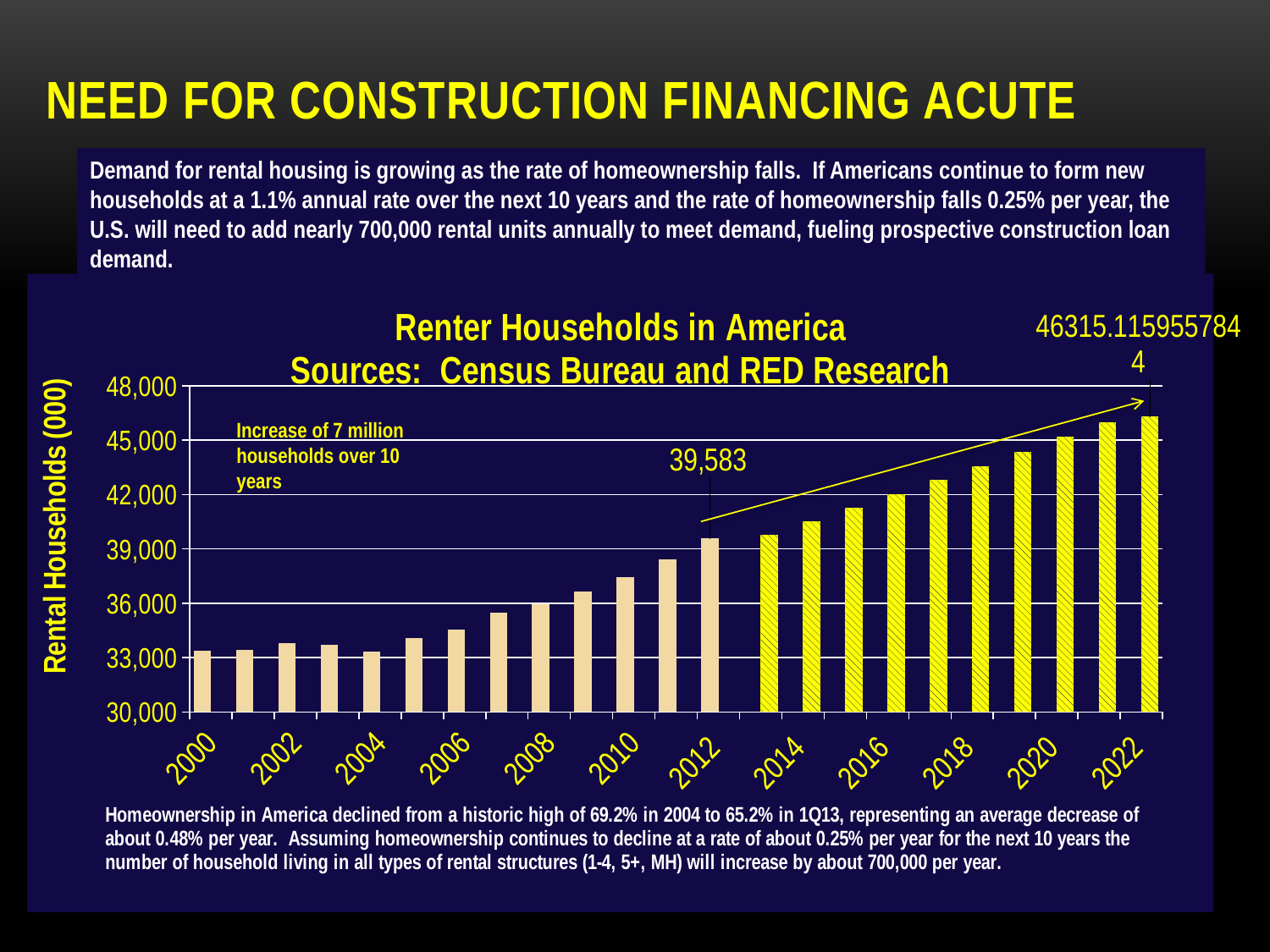
Is the value for 2016 greater or less than 39,000? greater Which year has the highest value in the Renter Households in America chart? 2022 What kind of chart is shown on the slide? bar chart How many years (bars) are plotted in the Renter Households in America chart? 23 Do the values in the Renter Households in America chart generally rise or fall from 2000 to 2022? rise Is the value for 2020 greater or less than 42,000? greater What is the label on the vertical axis of the chart? Rental Households (000) What is the value for 2012 in the Renter Households in America chart? 39,583 What are the sources named in the chart title? Census Bureau and RED Research Is the value for 2000 greater or less than 36,000? less Which is larger, the value for 2012 or the value for 2006? 2012